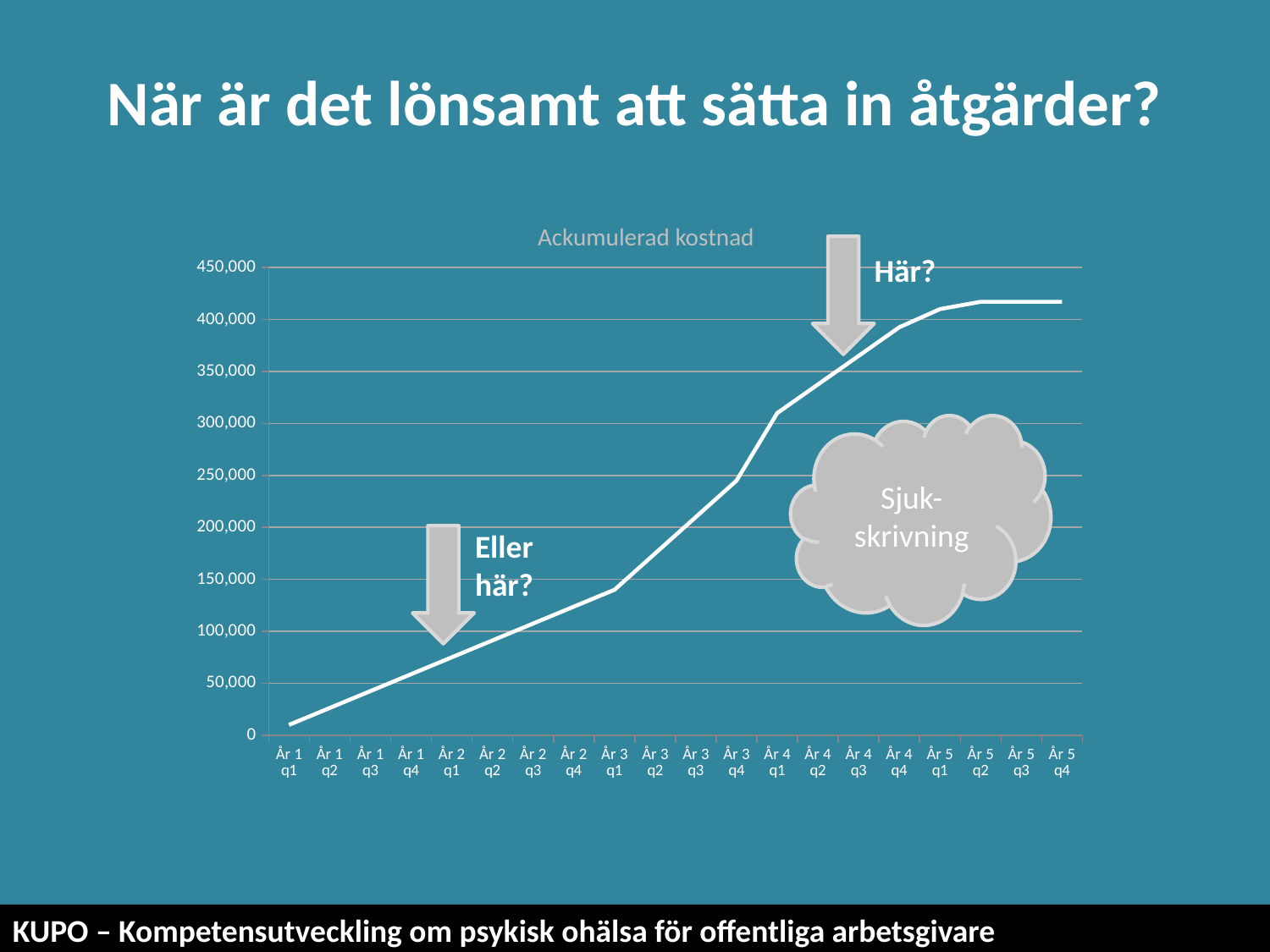
How many points are plotted along the x axis of the chart? 20 Which point on the x axis has the lowest value? År 1 q1 Is the value for År 5 q4 greater or less than 400,000? greater Is the value for År 1 q1 greater or less than 50,000? less Which is larger, the value for År 2 q4 or the value for År 4 q2? År 4 q2 What kind of chart is shown on the slide? line chart What is the title of the chart? Ackumulerad kostnad Do the values rise or fall along the x axis from År 1 q1 to År 5 q4? rise Is the value for År 3 q2 greater or less than 200,000? less What is the highest value shown on the y axis of the chart? 450,000